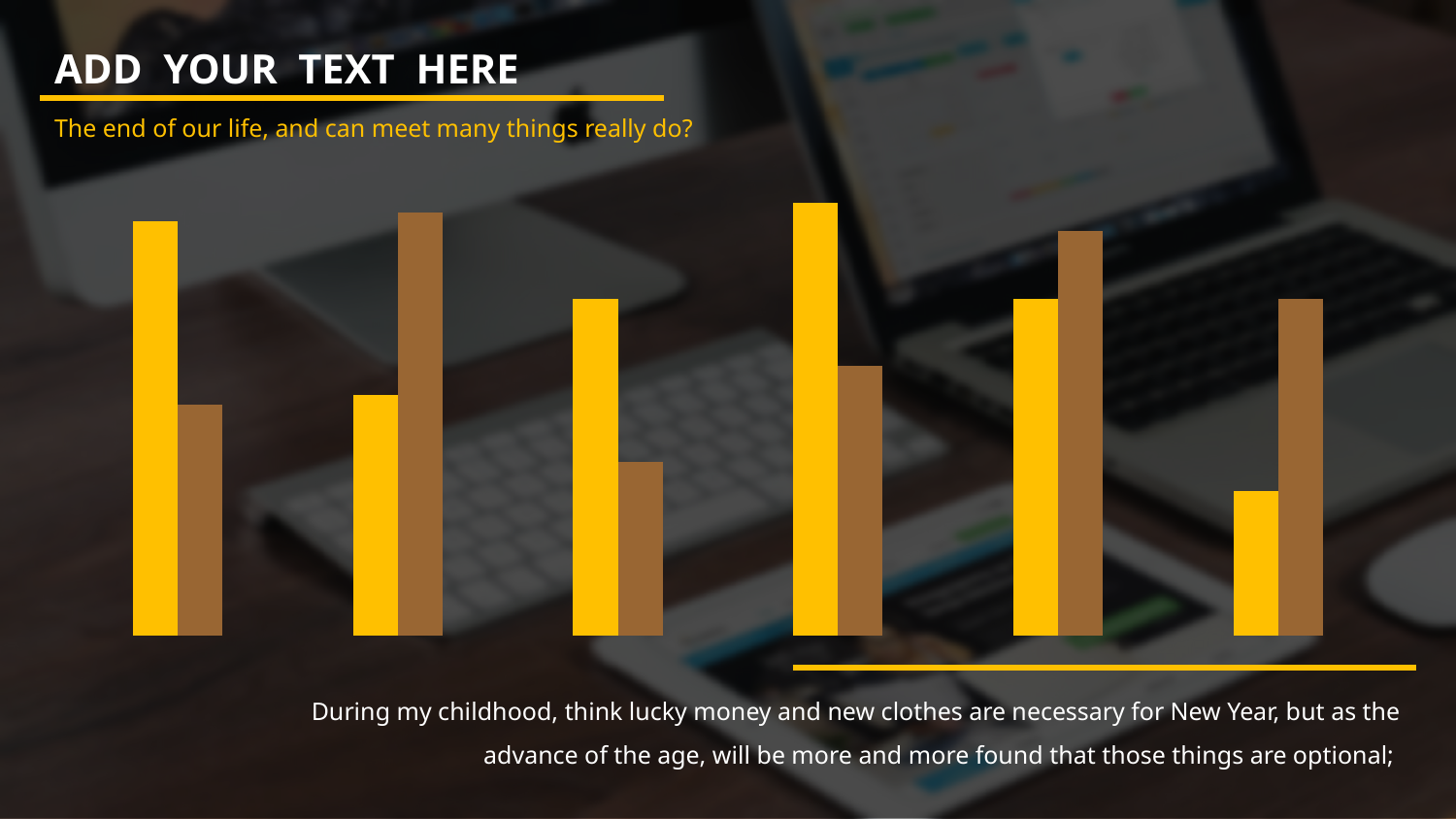
Does the chart display any data labels or axis values? No In the sixth group from the left, which bar is taller, the yellow one or the brown one? the brown one Which group from the left has the tallest yellow bar? the fourth group In the second group from the left, which bar is taller, the yellow one or the brown one? the brown one How many groups of bars does the chart contain? 6 In the third group from the left, which bar is taller, the yellow one or the brown one? the yellow one Which group from the left has the shortest yellow bar? the sixth group What kind of chart is shown on the slide? bar chart Which group from the left has the shortest brown bar? the third group What two colours are used for the bars in the chart? yellow and brown How many bars are in each group of the chart? 2